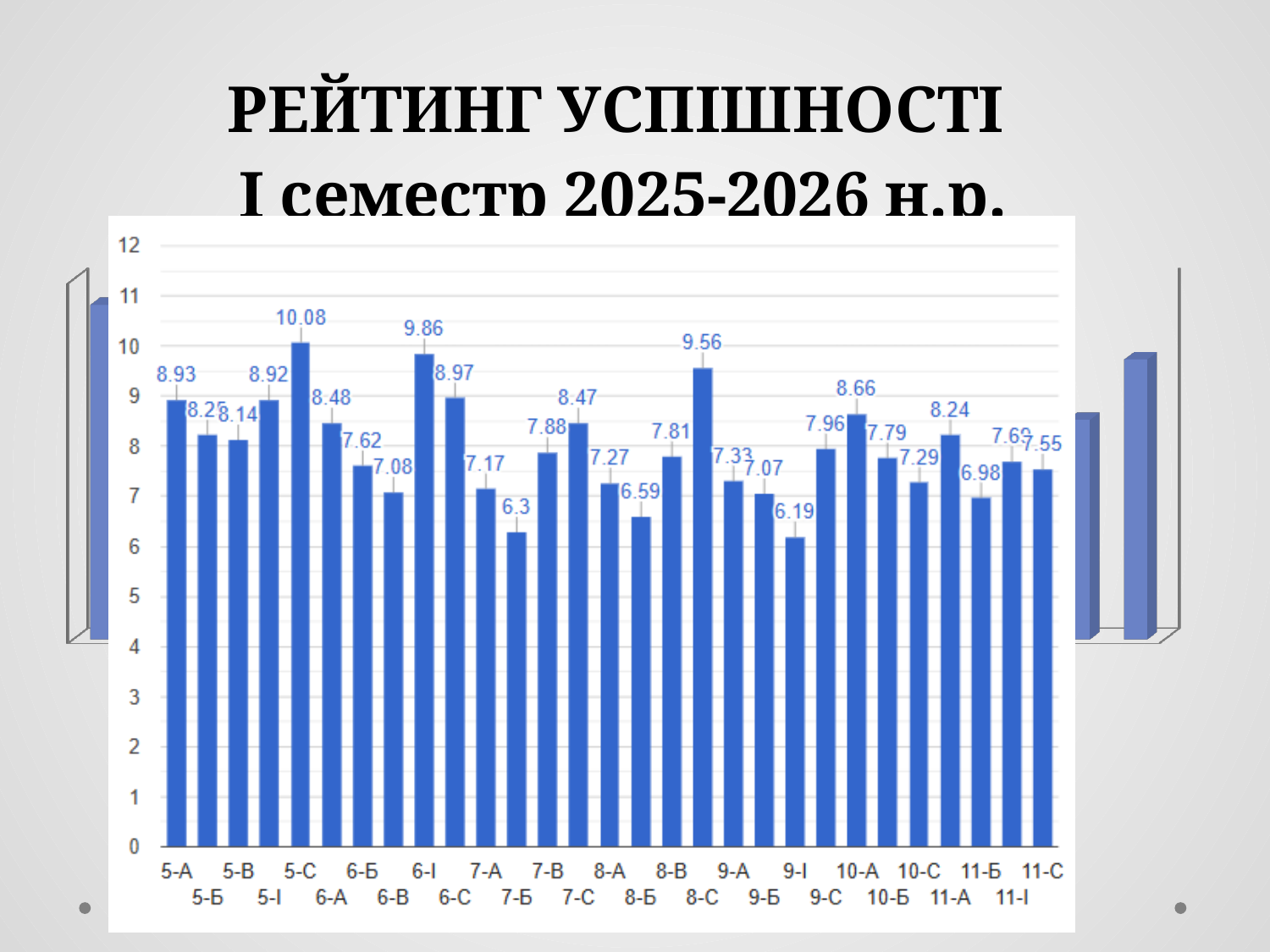
Which class has the lowest value? 9-І What is the value for 7-Б? 6.3 Which class has the highest value? 5-С What kind of chart is shown on the slide? bar chart How many classes are shown on the x axis? 29 Is the value for 7-Б greater or less than 7? less What is the value for 9-І? 6.19 What is the difference between the values for 5-С and 6-І? 0.22 Which is larger, the value for 8-С or the value for 10-А? 8-С What is the value for 11-С? 7.55 What is the difference between the values for 8-А and 8-Б? 0.68 What is the value for 5-С? 10.08